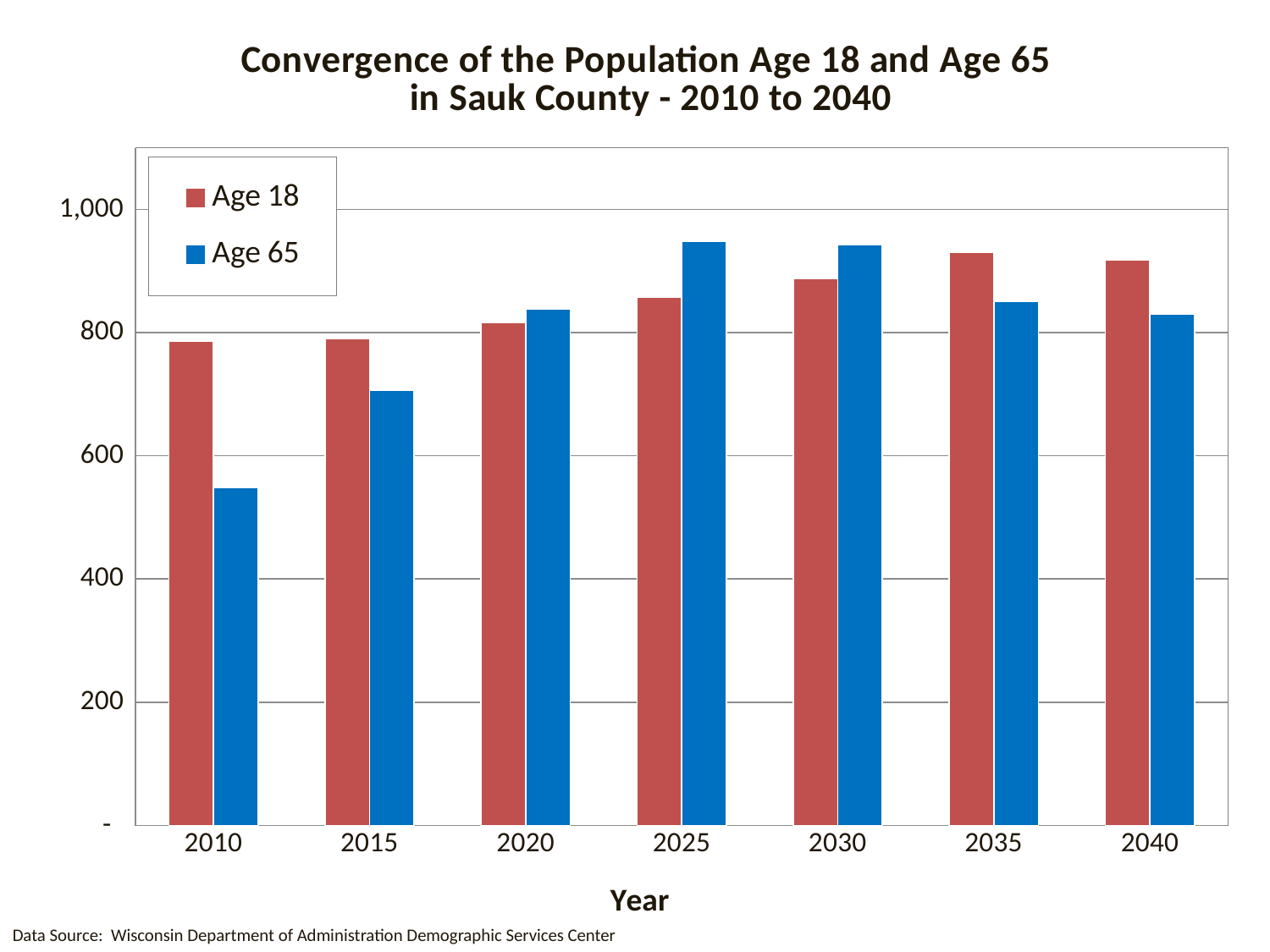
In 2010, which is larger, the Age 18 value or the Age 65 value? Age 18 How many series does the legend list? 2 In 2035, which is larger, the Age 18 value or the Age 65 value? Age 18 What is the label on the x axis? Year Is the Age 65 value for 2025 greater or less than 800? greater How many years are shown on the x axis? 7 Is the Age 18 value for 2010 greater or less than 800? less In 2025, which is larger, the Age 18 value or the Age 65 value? Age 65 Do the Age 65 values rise or fall from 2010 to 2025? Rise In which year is the Age 65 value lowest? 2010 Is the Age 65 value for 2010 greater or less than 600? less What kind of chart is shown on the slide? Bar chart